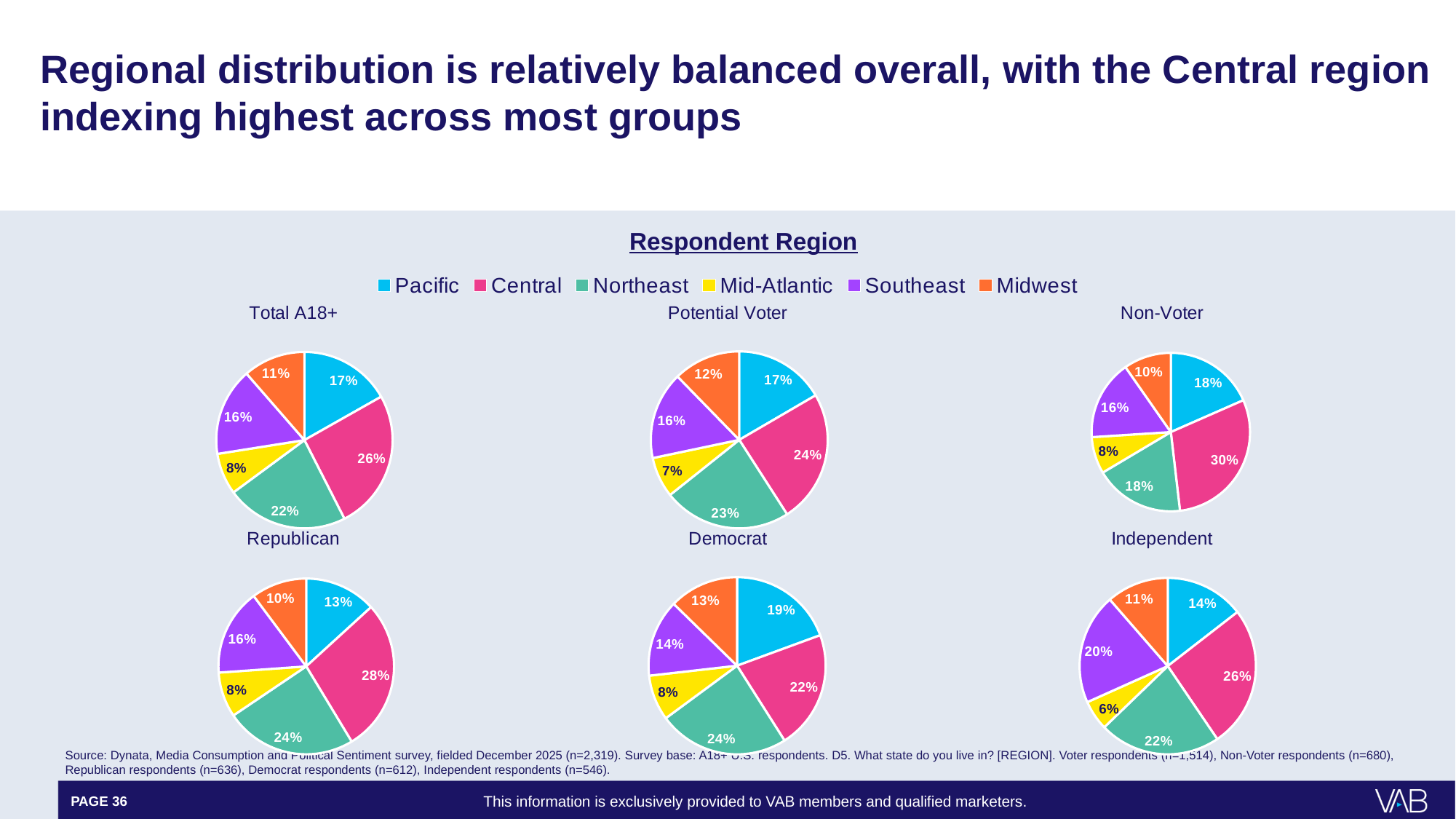
In the Independent pie chart, which region has the smallest share? Mid-Atlantic Which colour represents the Midwest region in the legend? Orange How many pie charts are shown on the slide? 6 How many series does the legend list for the Respondent Region charts? 6 In the Democrat pie chart, which region has the largest share? Northeast In the Total A18+ pie chart, what share of respondents are from the Central region? 26% In the Potential Voter pie chart, what is the share for the Mid-Atlantic region? 7% In the Republican pie chart, what is the difference between the Central share and the Pacific share? 15 percentage points What kind of chart is used for the Republican group? Pie chart In the Potential Voter pie chart, which is larger: the Central share or the Northeast share? Central In the Non-Voter pie chart, what is the share for the Central region? 30% In the Independent pie chart, what is the share for the Southeast region? 20%